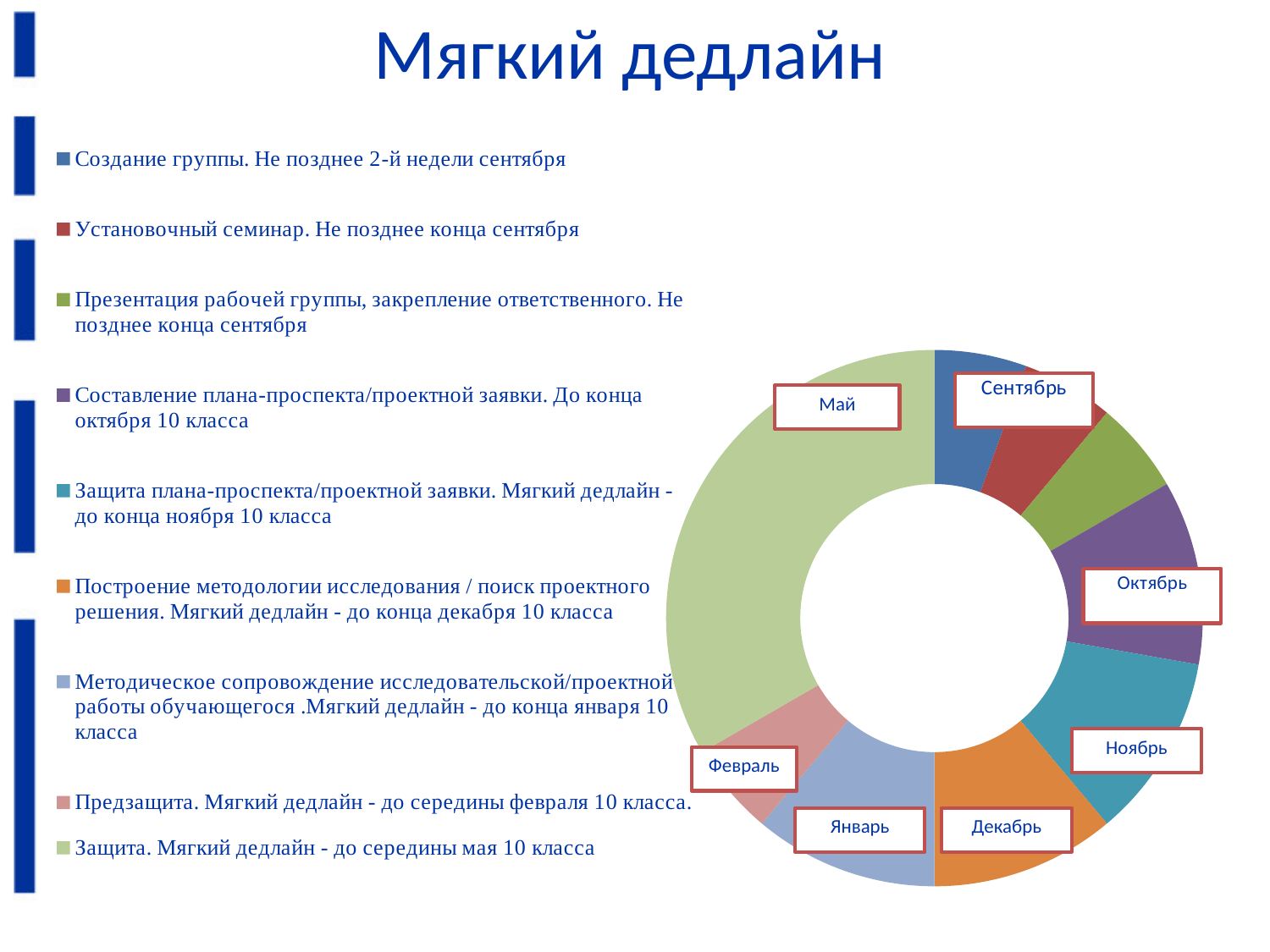
What kind of chart is shown on the slide? doughnut (pie) chart Which slice is larger, Май or Сентябрь? Май Which slice is larger, Ноябрь or Февраль? Ноябрь What is the title of the slide containing the chart? Мягкий дедлайн Which slice is larger, Январь or Сентябрь? Январь How many entries does the legend list? 9 Which slice of the doughnut chart is the largest? Май (Защита. Мягкий дедлайн - до середины мая 10 класса) How many slices does the doughnut chart have? 9 Which month label is placed on the orange slice of the chart? Декабрь